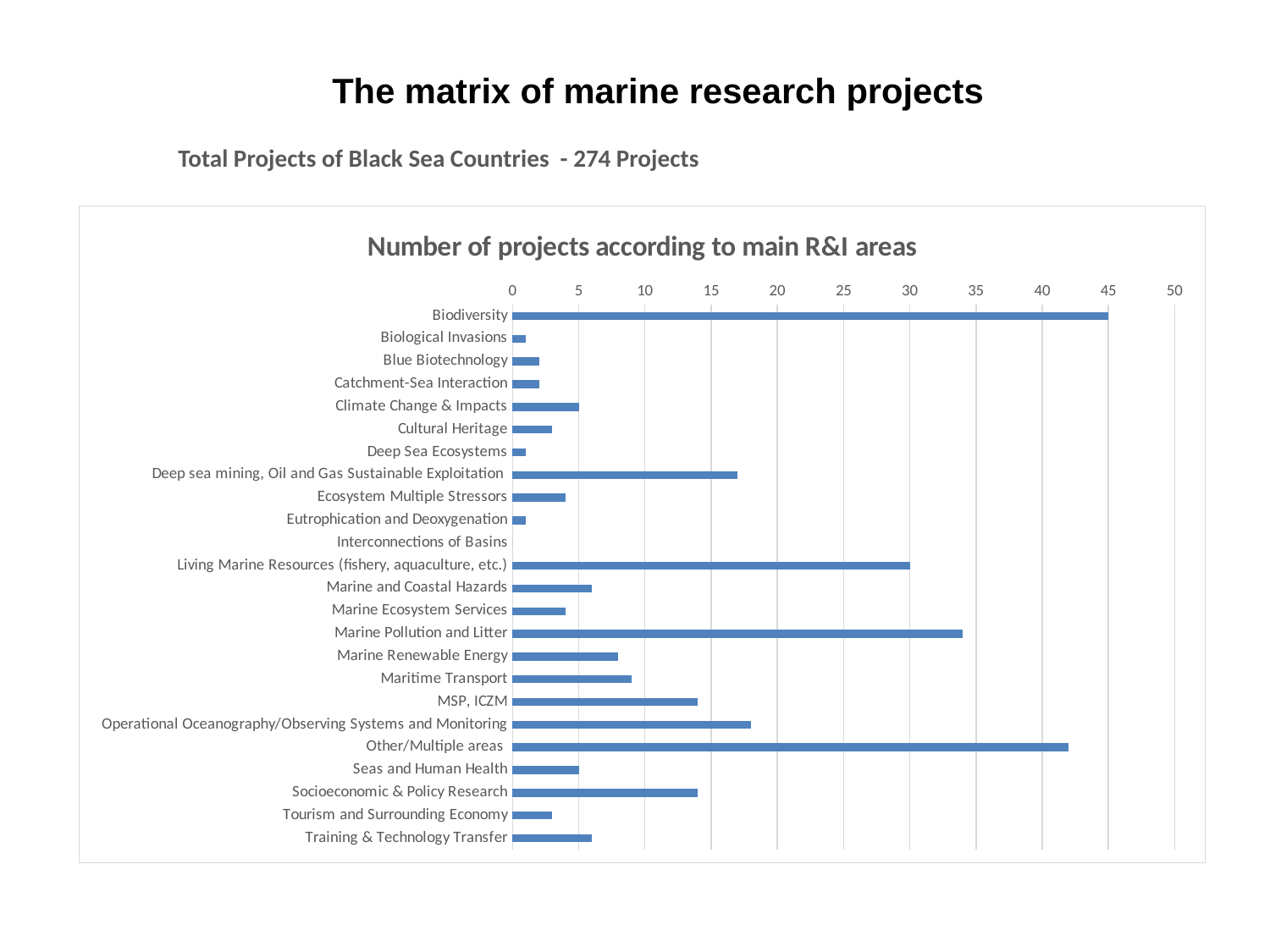
How many projects are shown for Biodiversity? 45 What kind of chart is shown on the slide? bar chart Which R&I area has the lowest number of projects? Interconnections of Basins Which has more projects, Other/Multiple areas or Marine Pollution and Litter? Other/Multiple areas How many R&I areas (categories) are listed on the chart? 24 Which has more projects, MSP, ICZM or Marine Renewable Energy? MSP, ICZM Which R&I area has the highest number of projects? Biodiversity Is the value for Marine Pollution and Litter greater or less than 30? greater What is the title of the chart? Number of projects according to main R&I areas How many projects are shown for Living Marine Resources (fishery, aquaculture, etc.)? 30 Is the value for Maritime Transport greater or less than 10? less Is the value for Other/Multiple areas greater or less than 40? greater